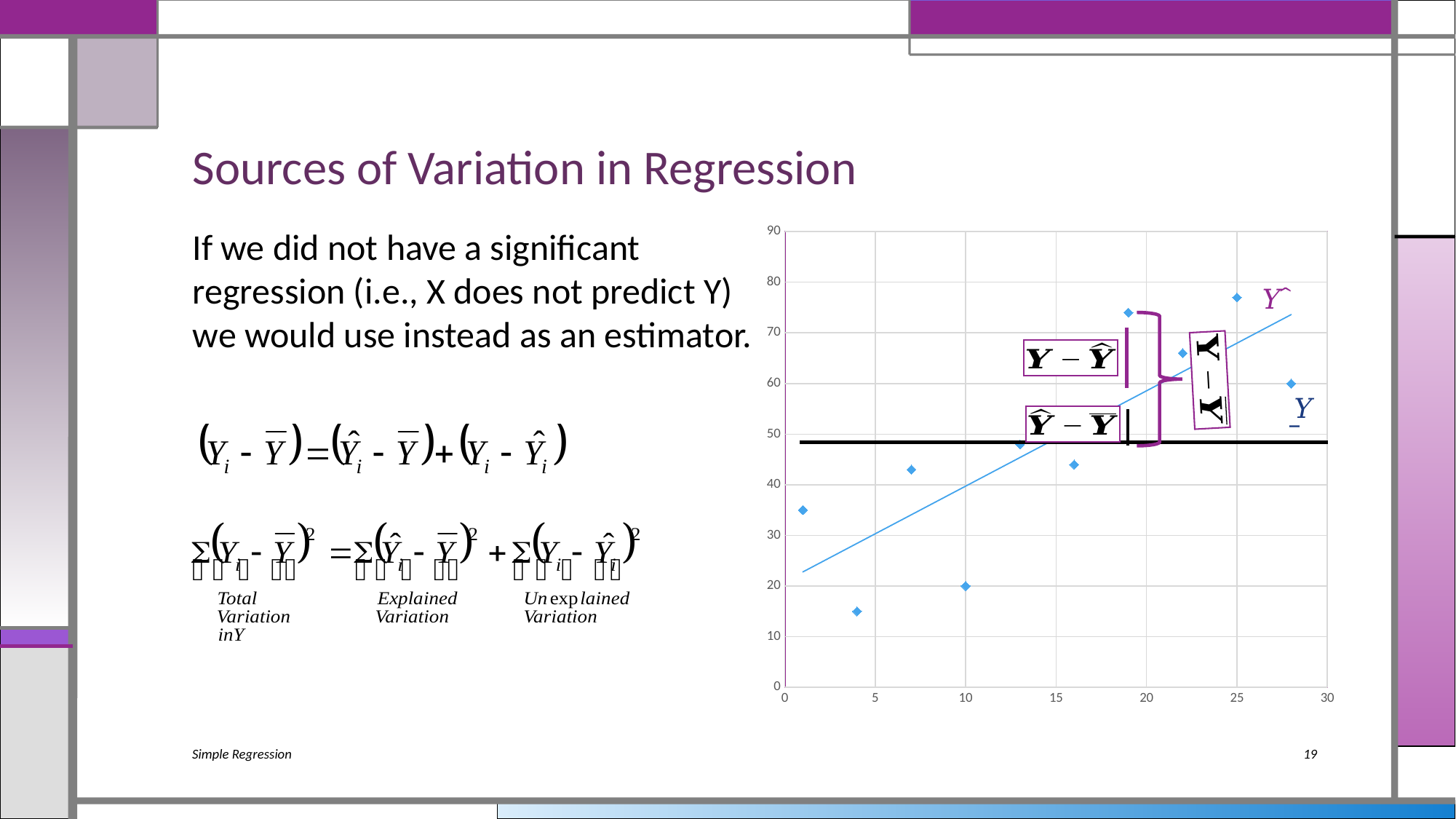
Which point has a larger y value, the one at x = 7 or the one at x = 10? x = 7 Is the value of the point at x = 19 greater or less than 70? greater Is the value of the point at x = 4 greater or less than 20? less Do the plotted points generally rise or fall as x increases? rise What is the maximum value shown on the vertical axis of the chart? 90 How many data points are plotted in the scatter chart? 10 What kind of chart is shown on the slide? scatter chart Which point has a larger y value, the one at x = 16 or the one at x = 22? x = 22 Is the value of the point at x = 10 greater or less than 30? less Which point has the lowest y value, the one at x = 4 or the one at x = 10? x = 4